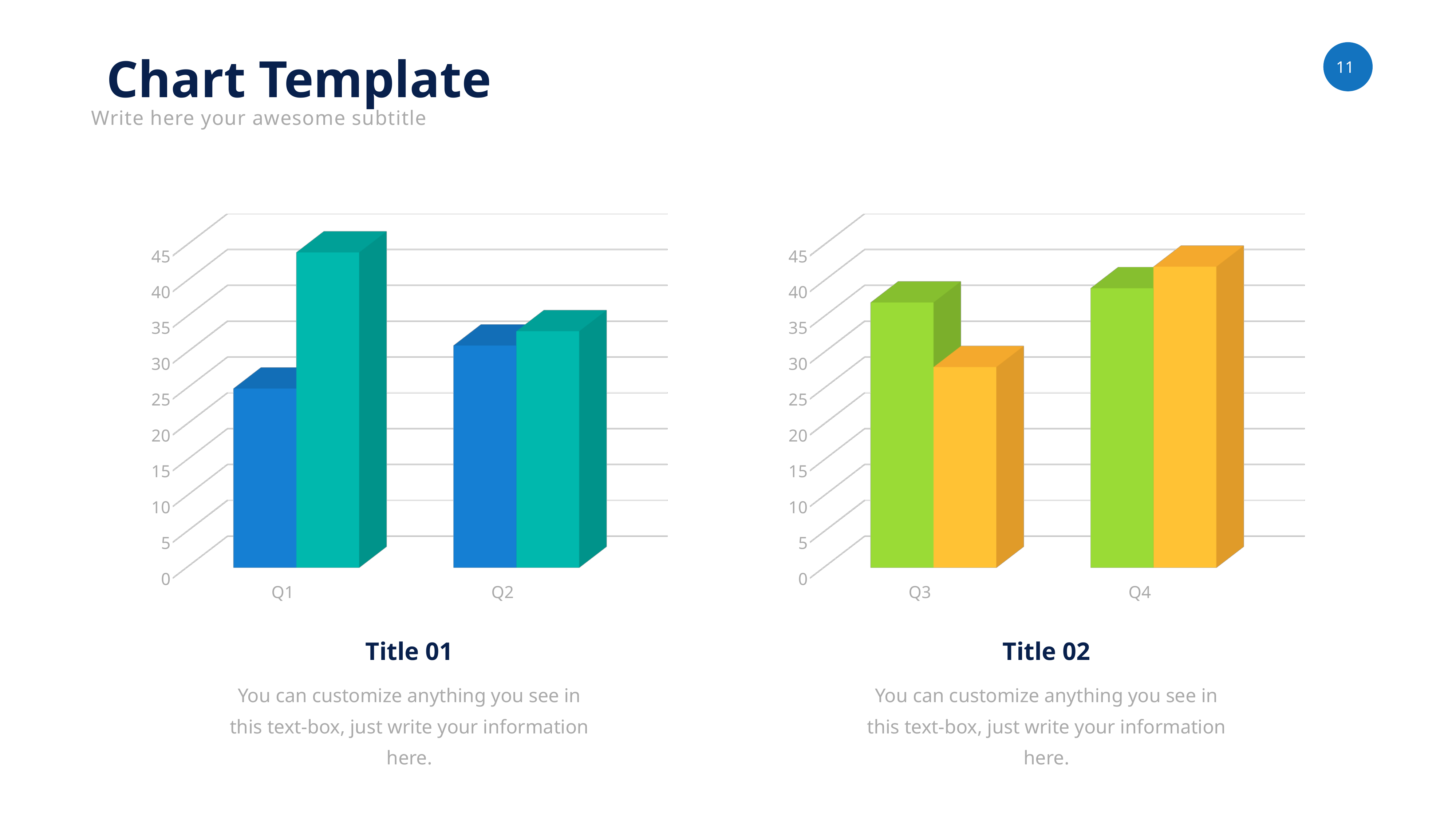
In the right chart, does the orange series rise or fall from Q3 to Q4? rise In the left chart, is the value of the teal bar for Q1 greater or less than 40? greater In the left chart, which bar is the tallest? the teal bar for Q1 In the right chart, how many categories are shown on the x axis? 2 In the left chart, does the blue series rise or fall from Q1 to Q2? rise In the left chart, which bar is the shortest? the blue bar for Q1 In the right chart, which bar is the shortest? the orange bar for Q3 In the left chart, is the value of the blue bar for Q1 greater or less than 30? less In the left chart, how many categories are shown on the x axis? 2 What kind of chart is the left chart? bar chart In the right chart, is the value of the orange bar for Q3 greater or less than 30? less In the right chart, for Q3, which is larger, the green bar or the orange bar? the green bar